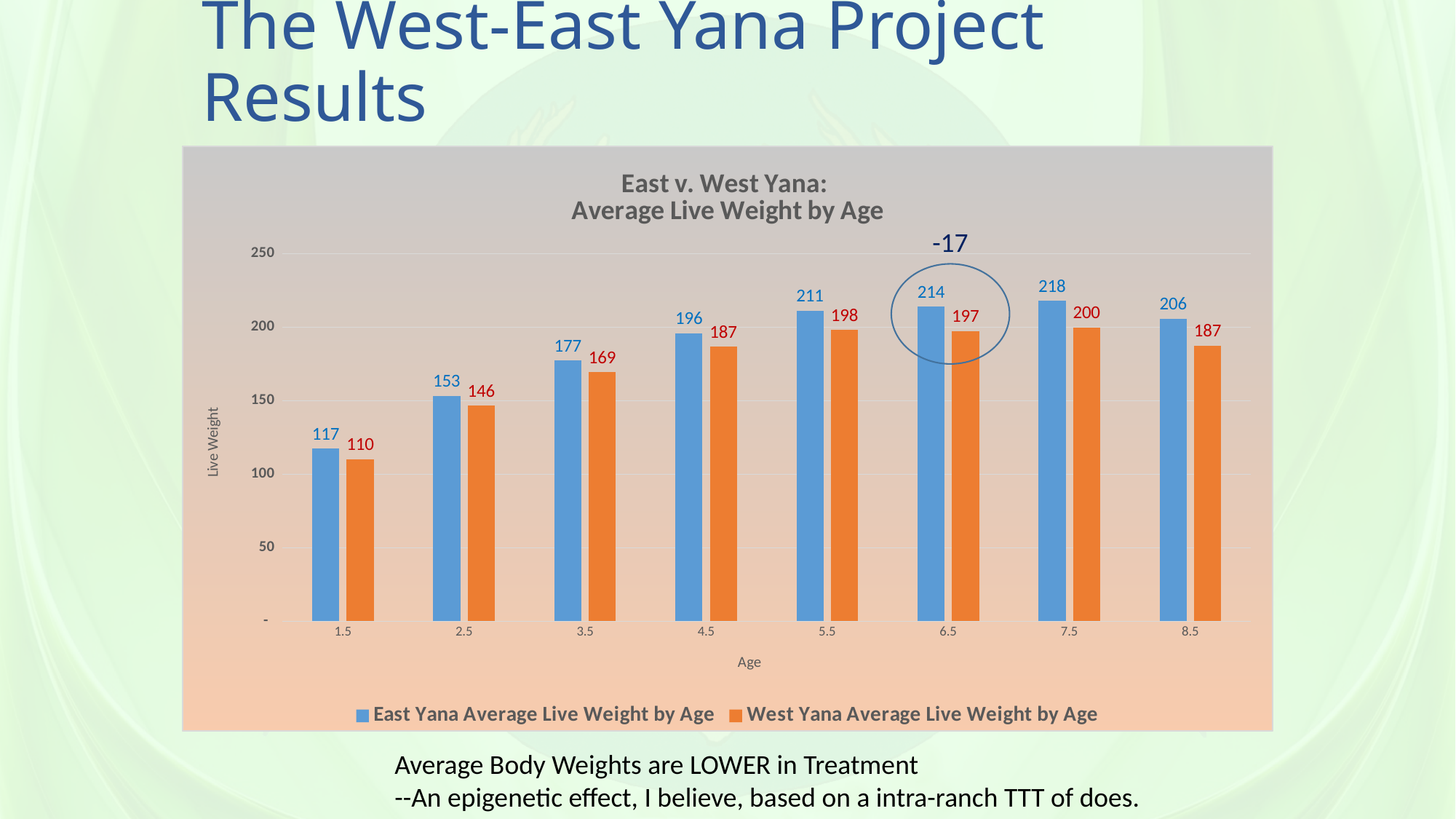
What is the title of the chart? East v. West Yana: Average Live Weight by Age What is the difference between the East Yana average live weights at age 7.5 and age 8.5? 12 How many age categories are shown on the x axis? 8 Does the West Yana average live weight rise or fall from age 1.5 to age 5.5? Rise What is the difference between the East Yana and West Yana average live weights at age 6.5? 17 What is the East Yana average live weight at age 6.5? 214 How many series does the legend list? 2 At which age is the East Yana average live weight highest? 7.5 At which age is the West Yana average live weight lowest? 1.5 What is the West Yana average live weight at age 3.5? 169 Which is larger at age 4.5, the East Yana or the West Yana average live weight? East Yana What kind of chart is shown on the slide? Bar chart